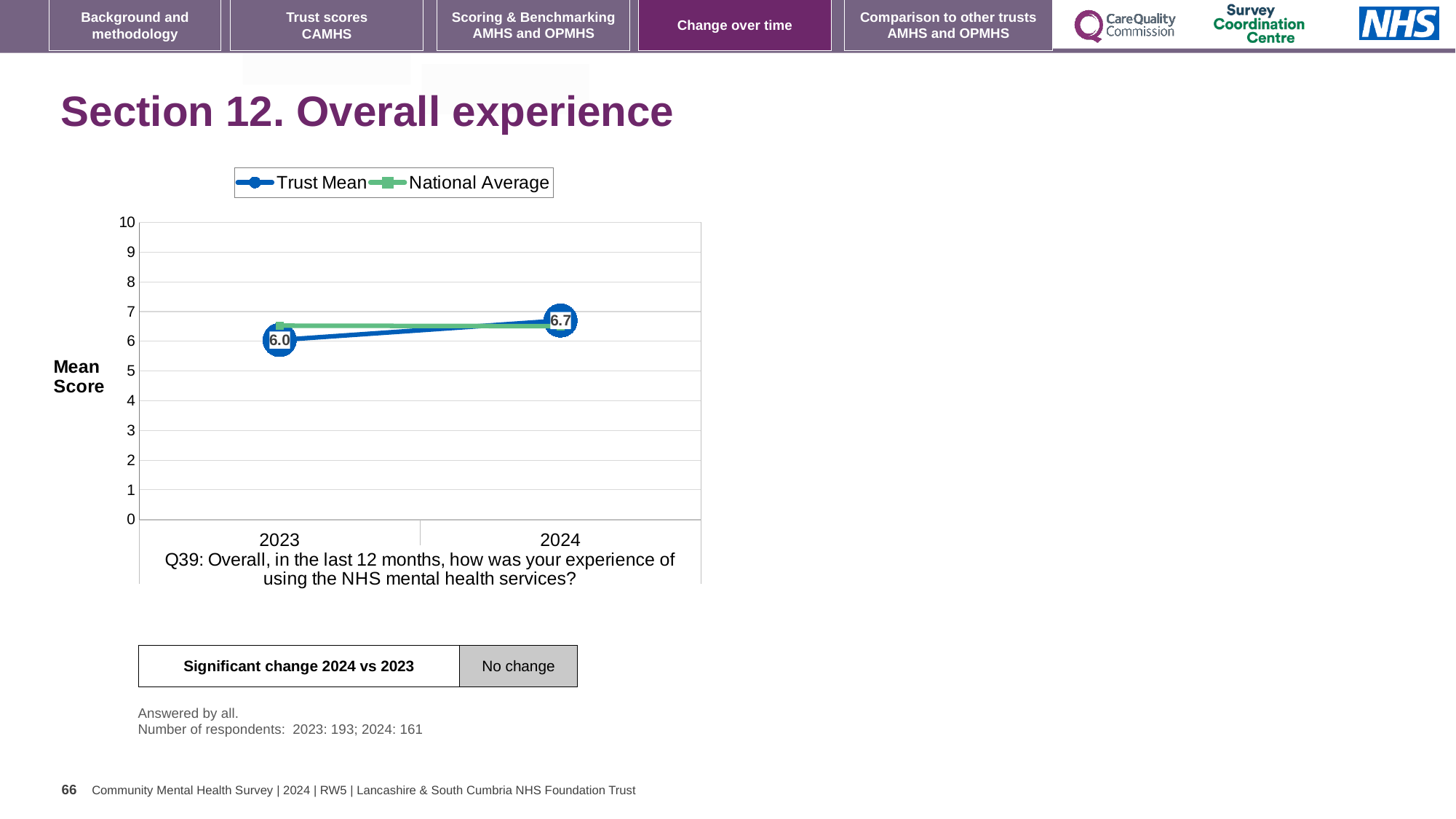
What is the Trust Mean value for 2023? 6.0 What is the difference between the Trust Mean in 2024 and in 2023? 0.7 How many series does the chart legend list? 2 In 2023, which is larger: the Trust Mean or the National Average? National Average Is the National Average value for 2023 greater or less than 6? greater In which year is the Trust Mean highest? 2024 What kind of chart is shown on the slide? Line chart What is the Trust Mean value for 2024? 6.7 How many years are plotted on the x axis of the chart? 2 Is the National Average value for 2024 greater or less than 7? less In which year is the Trust Mean lowest? 2023 Does the Trust Mean rise or fall from 2023 to 2024? Rise